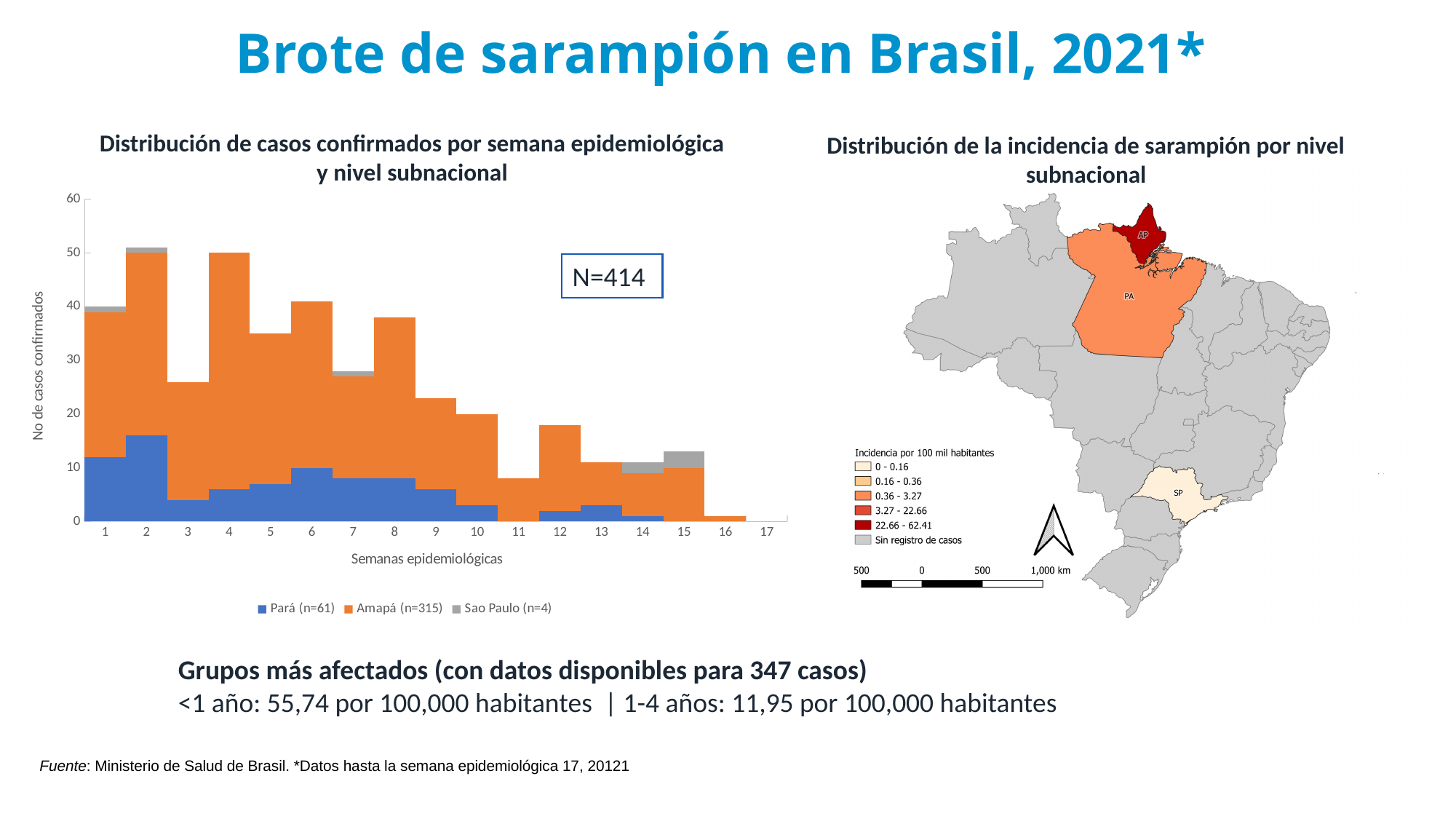
How many series does the legend of the bar chart list? 3 In the bar chart, which week has more total confirmed cases, week 3 or week 4? Week 4 In the bar chart, which epidemiological week has the fewest confirmed cases? Week 17 In the bar chart, is the total number of confirmed cases in week 3 greater or less than 30? less In the bar chart, is the number of Pará cases in week 2 greater or less than 10? greater What kind of chart is 'Distribución de casos confirmados por semana epidemiológica y nivel subnacional'? Stacked bar chart In the bar chart, is the total number of confirmed cases in week 11 greater or less than 10? less In the bar chart, do the total confirmed cases generally rise or fall from week 8 to week 17? Fall What total N is shown in the box on the bar chart? N=414 How many epidemiological weeks are shown on the x axis of the bar chart? 17 In the bar chart legend, how many cases (n) are given for Amapá? 315 In the bar chart legend, how many cases (n) are given for Pará? 61